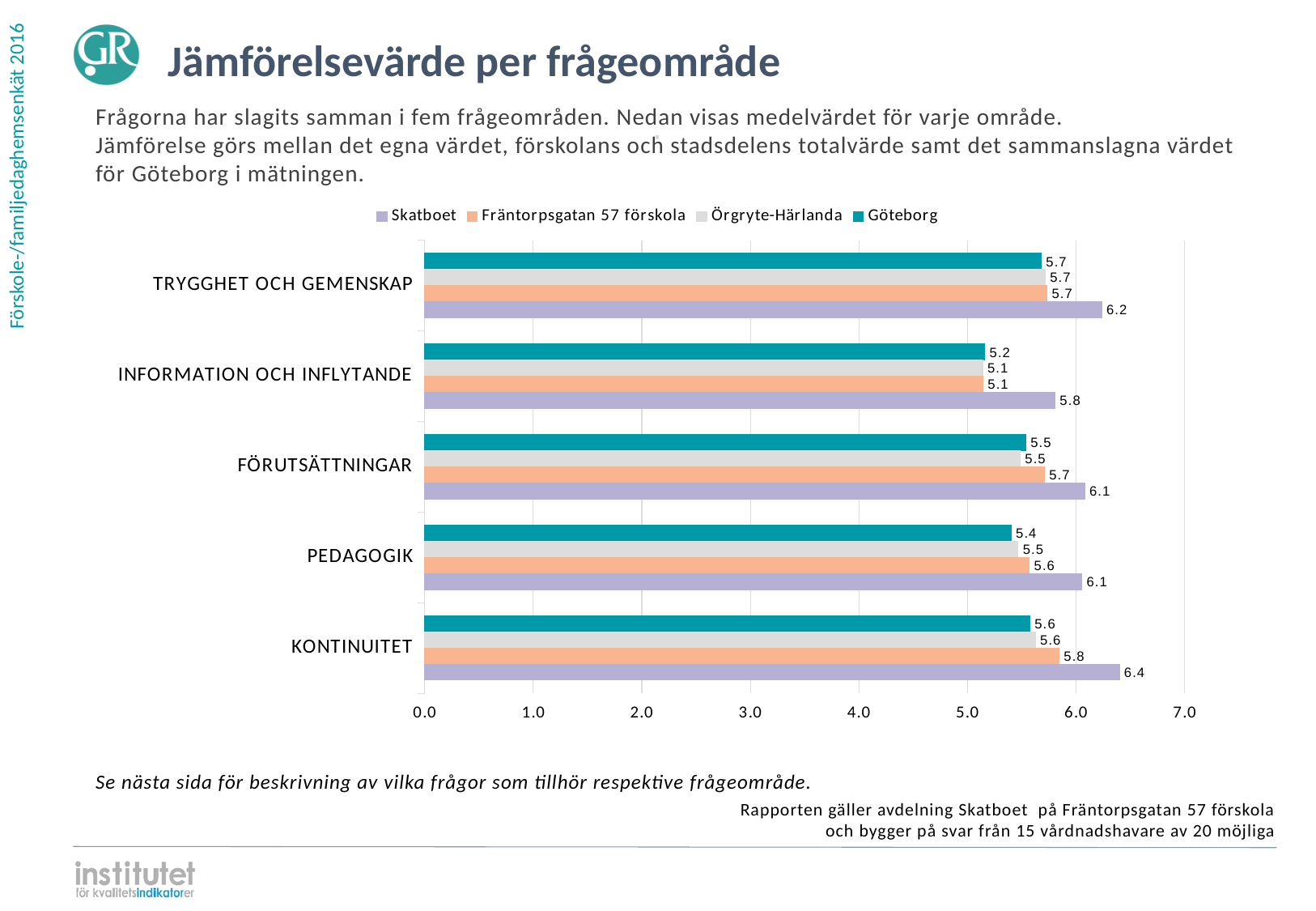
Which category has the highest value for Skatboet? KONTINUITET What is the value for Skatboet in the KONTINUITET category? 6.4 Is the value for Skatboet in the INFORMATION OCH INFLYTANDE category greater or less than 5.0? greater Which category has the lowest value for Skatboet? INFORMATION OCH INFLYTANDE What is the title of the slide? Jämförelsevärde per frågeområde What is the value for Fräntorpsgatan 57 förskola in the PEDAGOGIK category? 5.6 What is the value for Göteborg in the INFORMATION OCH INFLYTANDE category? 5.2 What is the difference between the Skatboet value and the Göteborg value in the TRYGGHET OCH GEMENSKAP category? 0.5 What kind of chart is shown on the slide? Bar chart How many series does the legend list? 4 Which is larger in the FÖRUTSÄTTNINGAR category: the value for Fräntorpsgatan 57 förskola or the value for Örgryte-Härlanda? Fräntorpsgatan 57 förskola How many categories (frågeområden) are shown on the chart? 5